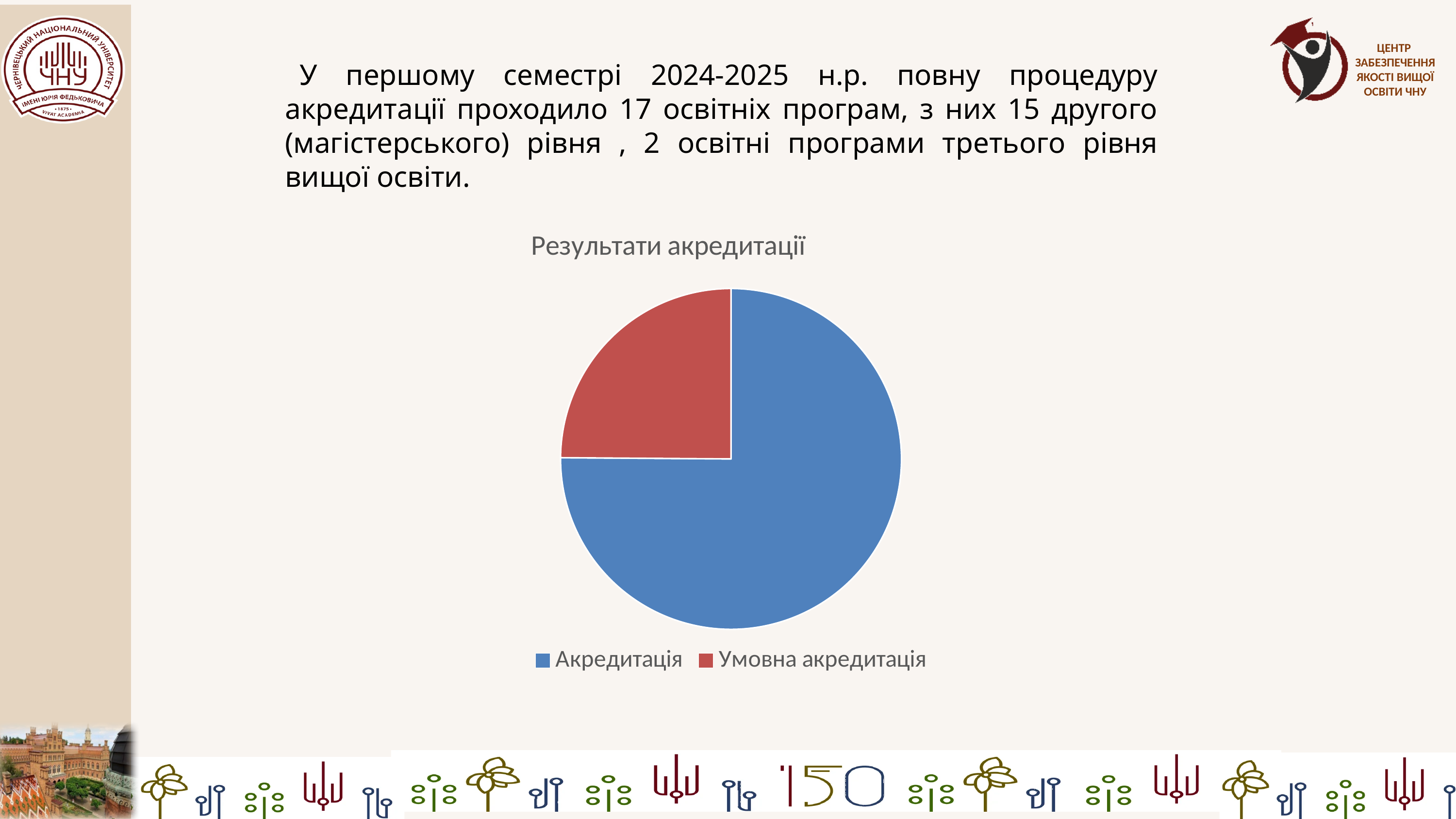
In the pie chart, which slice is larger: "Акредитація" or "Умовна акредитація"? Акредитація Which category has the largest slice in the pie chart "Результати акредитації"? Акредитація What colour is the "Умовна акредитація" slice in the pie chart? red How many slices does the pie chart "Результати акредитації" have? 2 Which category has the smallest slice in the pie chart "Результати акредитації"? Умовна акредитація What kind of chart is shown under the title "Результати акредитації"? pie chart What is the title of the chart on the slide? Результати акредитації How many entries does the legend of the pie chart list? 2